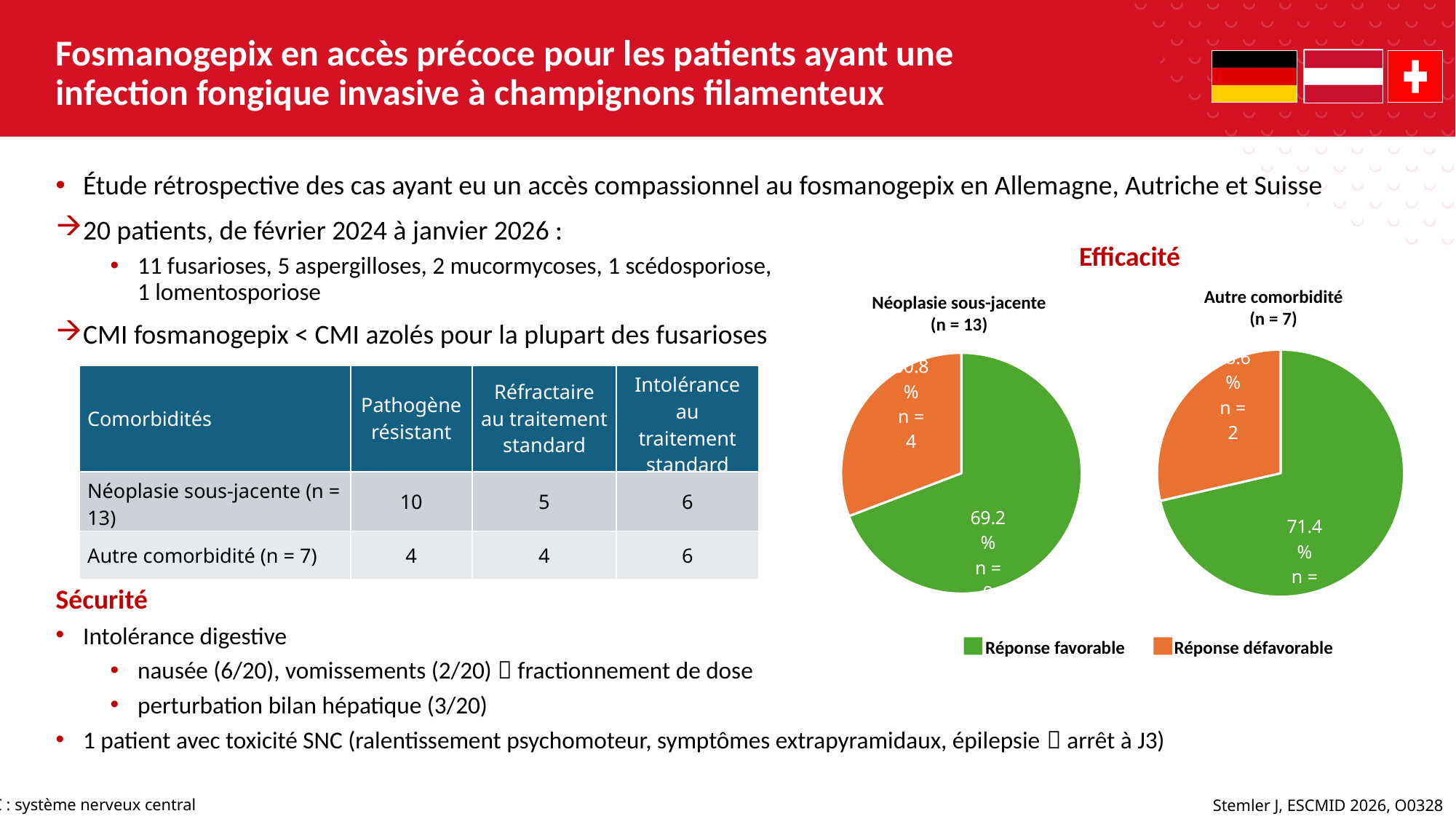
In the 'Néoplasie sous-jacente (n = 13)' pie chart, what percentage is shown for 'Réponse favorable'? 69.2% In the 'Néoplasie sous-jacente (n = 13)' pie chart, which slice is larger: 'Réponse favorable' or 'Réponse défavorable'? Réponse favorable In the 'Autre comorbidité (n = 7)' pie chart, what percentage is shown for 'Réponse favorable'? 71.4% In the 'Autre comorbidité (n = 7)' pie chart, how many patients (n) had a 'Réponse défavorable'? n = 2 In the 'Néoplasie sous-jacente (n = 13)' pie chart, which slice is the largest? Réponse favorable Which of the two pie charts shows the higher 'Réponse favorable' percentage: 'Néoplasie sous-jacente (n = 13)' or 'Autre comorbidité (n = 7)'? Autre comorbidité (n = 7) In the 'Autre comorbidité (n = 7)' pie chart, which slice is the smallest? Réponse défavorable How many slices does each pie chart under 'Efficacité' have? 2 In the 'Néoplasie sous-jacente (n = 13)' pie chart, how many patients (n) had a 'Réponse défavorable'? n = 4 What kind of chart is used under the 'Efficacité' heading? pie chart In the 'Efficacité' pie charts, which colour represents 'Réponse défavorable'? orange How many entries does the legend of the 'Efficacité' pie charts list? 2